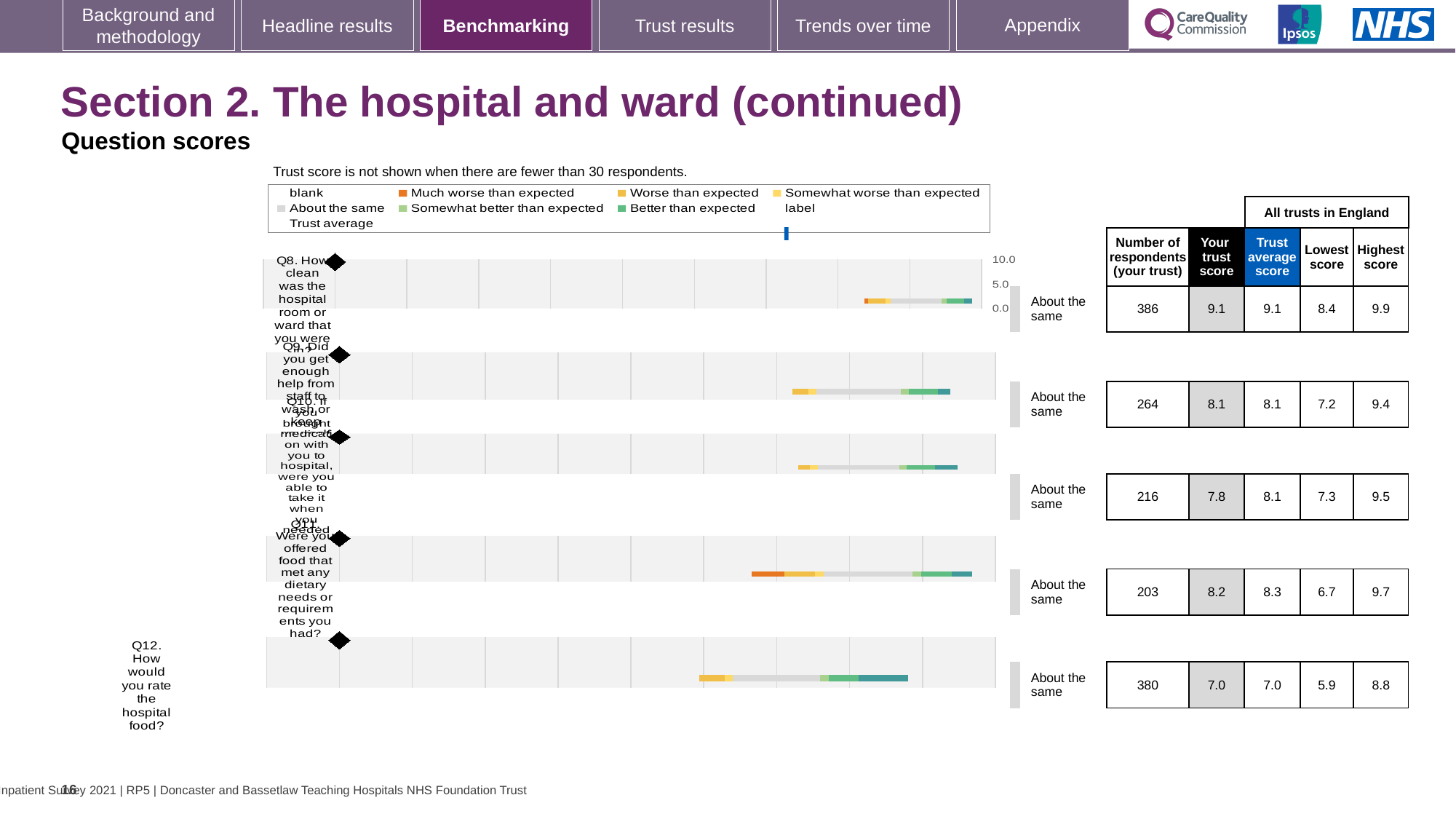
For Q10, what is the difference between the trust average score and 'Your trust score'? 0.3 What is the highest score among all trusts in England for Q11? 9.7 How many respondents does the table show for Q12 (How would you rate the hospital food)? 380 Which has the larger 'Your trust score', Q9 or Q11? Q11 For Q8, what is the difference between the highest score and the lowest score across all trusts in England? 1.5 What benchmark category label is shown next to each of the five questions? About the same What is the lowest score among all trusts in England for Q12? 5.9 How many questions (categories) are plotted in the chart? 5 Which question has the lowest 'Your trust score'? Q12 What kind of chart is used to show the question scores for Q8 to Q12? bar chart Which question has the highest 'Your trust score'? Q8 What is the 'Your trust score' for Q8 (How clean was the hospital room or ward)? 9.1